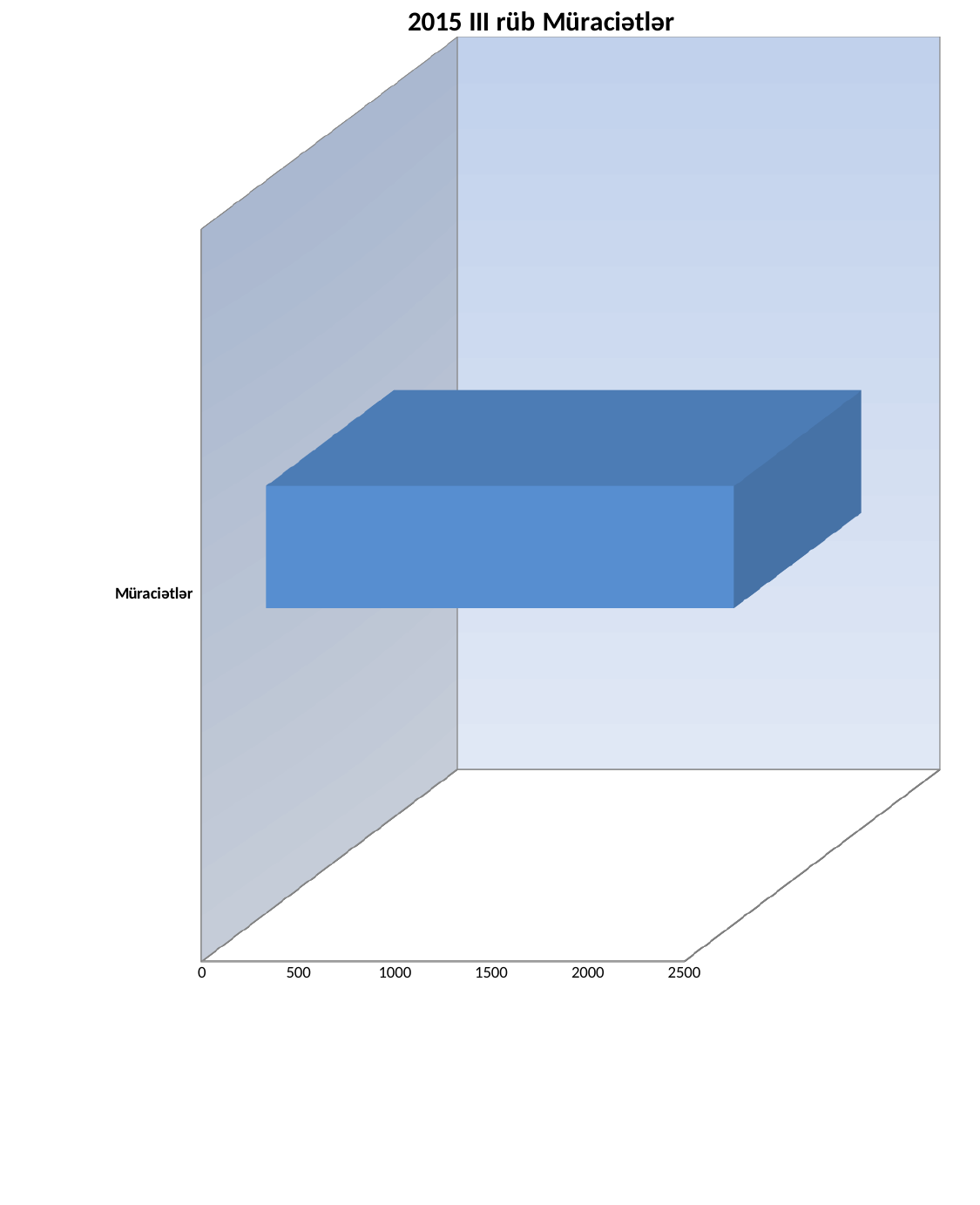
What kind of chart is shown on the slide? bar chart What is the label of the category shown on the vertical axis? Müraciətlər Is the value for Müraciətlər greater or less than 1500? greater How many bars are plotted in the chart? 1 Is the value for Müraciətlər greater or less than 1000? greater Is the value for Müraciətlər greater or less than 2000? greater What is the title of the chart? 2015 III rüb Müraciətlər What is the highest tick value shown on the horizontal axis? 2500